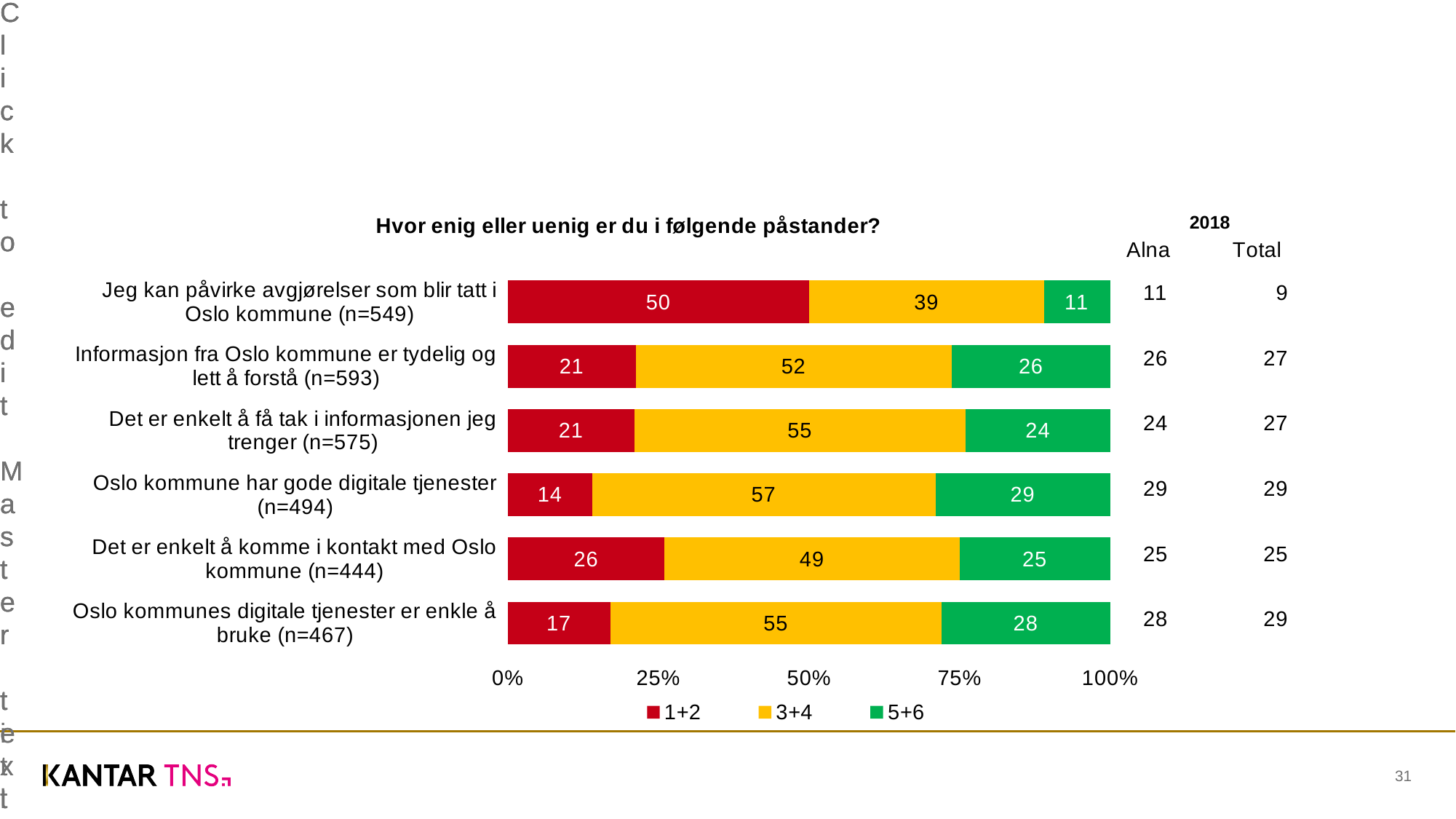
What is the value of the 3+4 series for "Oslo kommune har gode digitale tjenester (n=494)"? 57 What is the total of the stacked bar for "Det er enkelt å få tak i informasjonen jeg trenger (n=575)"? 100 Which statement has the lowest 5+6 value? Jeg kan påvirke avgjørelser som blir tatt i Oslo kommune (n=549) What is the value of the 1+2 series for "Jeg kan påvirke avgjørelser som blir tatt i Oslo kommune (n=549)"? 50 How many statements (categories) are shown in the chart? 6 Which is larger: the 5+6 value for "Informasjon fra Oslo kommune er tydelig og lett å forstå (n=593)" or the 5+6 value for "Det er enkelt å få tak i informasjonen jeg trenger (n=575)"? Informasjon fra Oslo kommune er tydelig og lett å forstå (n=593) What is the value of the 5+6 series for "Oslo kommunes digitale tjenester er enkle å bruke (n=467)"? 28 What is the title of the chart? Hvor enig eller uenig er du i følgende påstander? How many series does the legend list? 3 What kind of chart is shown on the slide? Stacked bar chart Which statement has the highest 1+2 value? Jeg kan påvirke avgjørelser som blir tatt i Oslo kommune (n=549) What is the difference between the 3+4 value and the 1+2 value for "Det er enkelt å komme i kontakt med Oslo kommune (n=444)"? 23